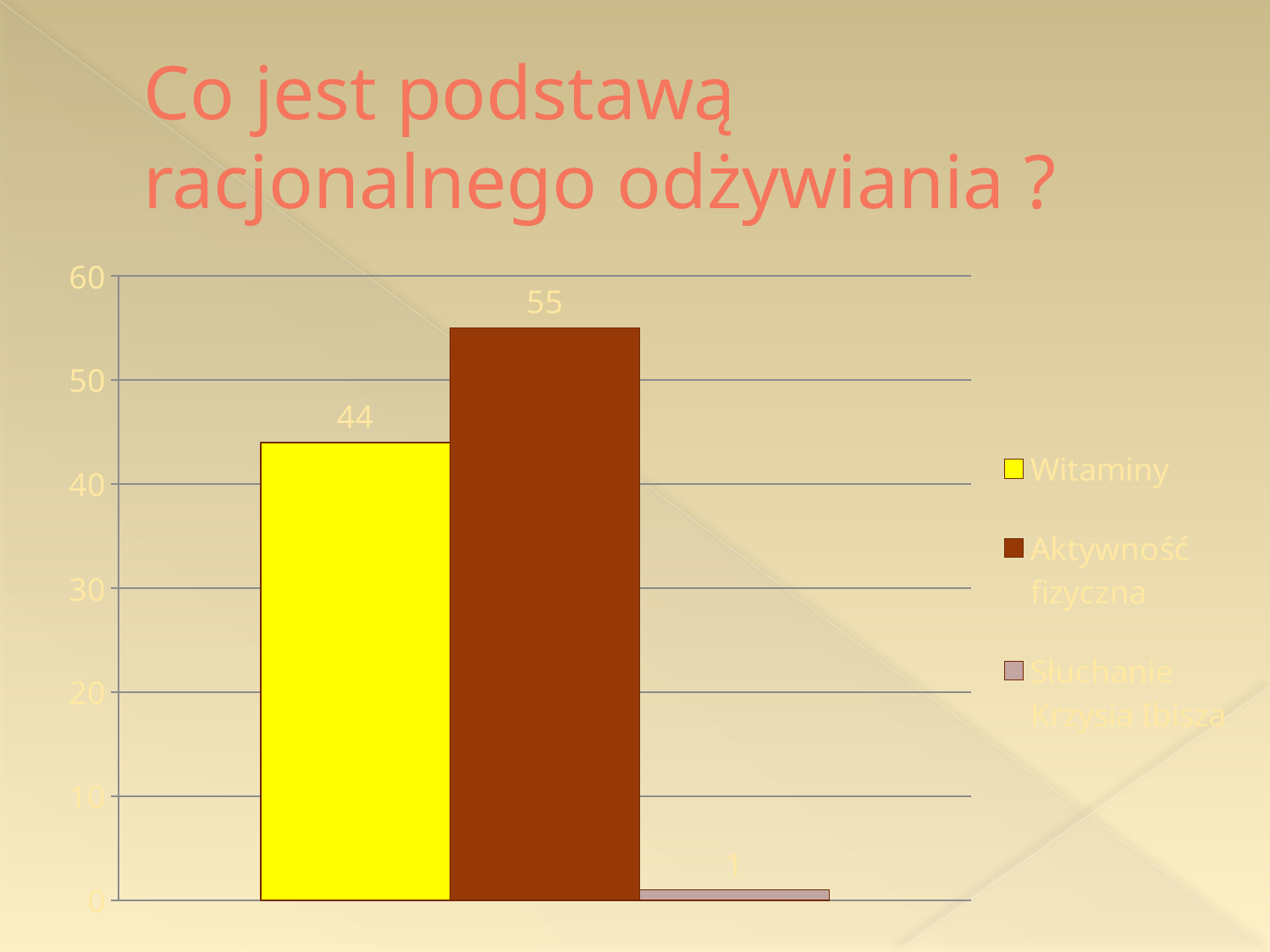
What is the difference between the values for Aktywność fizyczna and Witaminy? 11 Which series has the lowest value? Słuchanie Krzysia Ibisza How many series does the legend list? 3 What is the title of the slide above the chart? Co jest podstawą racjonalnego odżywiania ? Which is larger, the value for Witaminy or the value for Aktywność fizyczna? Aktywność fizyczna What kind of chart is shown on the slide? bar chart Which series has the highest value? Aktywność fizyczna Is the value for Witaminy greater or less than 40? greater What is the value for Aktywność fizyczna? 55 What colour is the bar for Witaminy? yellow What is the value for Witaminy? 44 What is the value for Słuchanie Krzysia Ibisza? 1